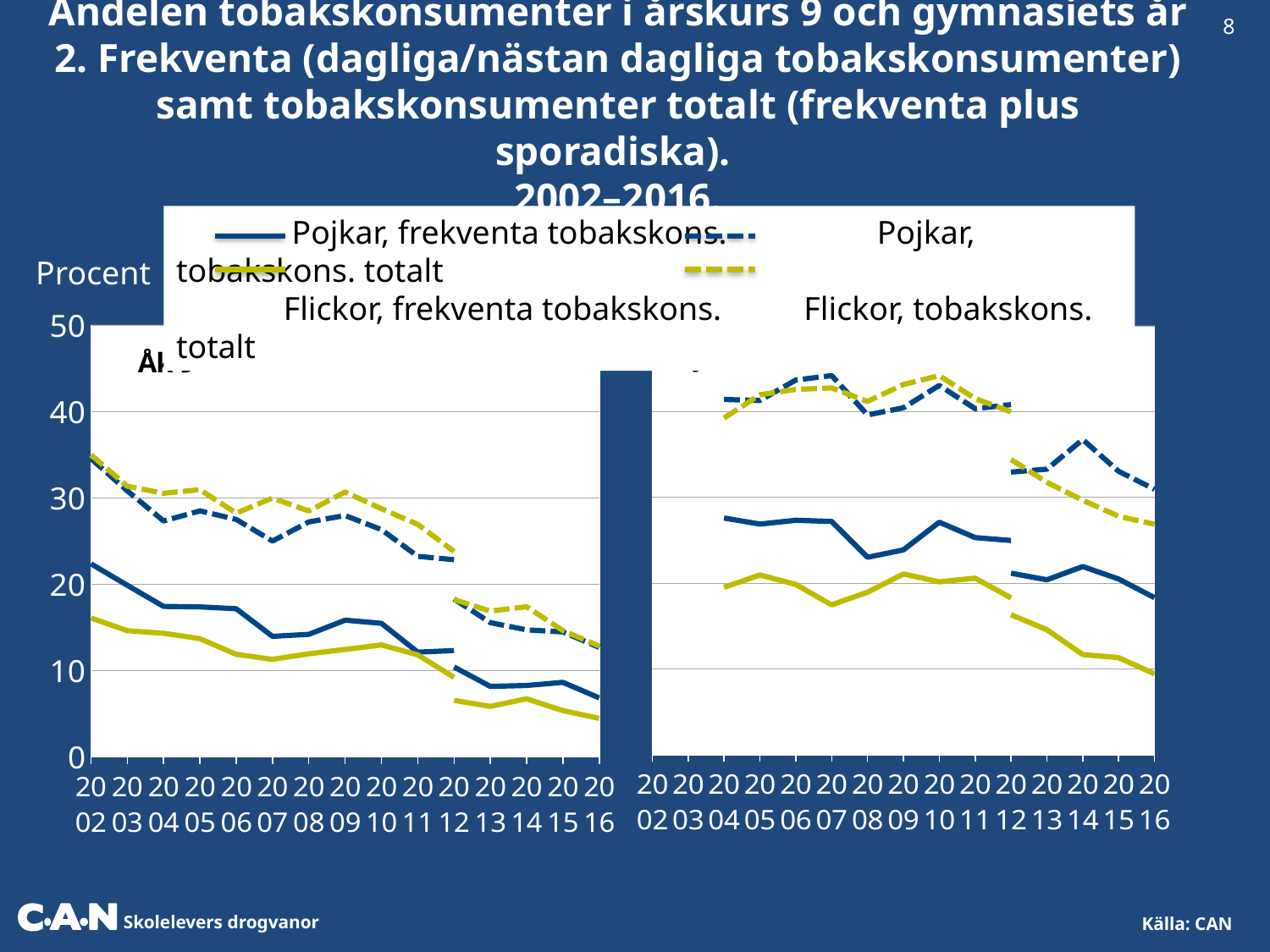
In the left chart, which is larger in 2002: Pojkar, frekventa tobakskons. or Flickor, frekventa tobakskons.? Pojkar, frekventa tobakskons. In the left chart, is the value for Pojkar, frekventa tobakskons. in 2002 greater or less than 20? greater In the left chart, does the Flickor, frekventa tobakskons. line rise or fall from 2002 to 2016? Fall How many years are shown along the x axis of the left chart? 15 What source is cited at the bottom of the slide? Källa: CAN How many series does the legend list? 4 What label is shown on the vertical axis of the charts? Procent What type of chart is used on this slide? Line chart In the right chart, is the value for Flickor, frekventa tobakskons. in 2012 greater or less than 20? less In the right chart, which series has the lowest value in 2016? Flickor, frekventa tobakskons. In the left chart, is the value for Flickor, frekventa tobakskons. in 2016 greater or less than 10? less